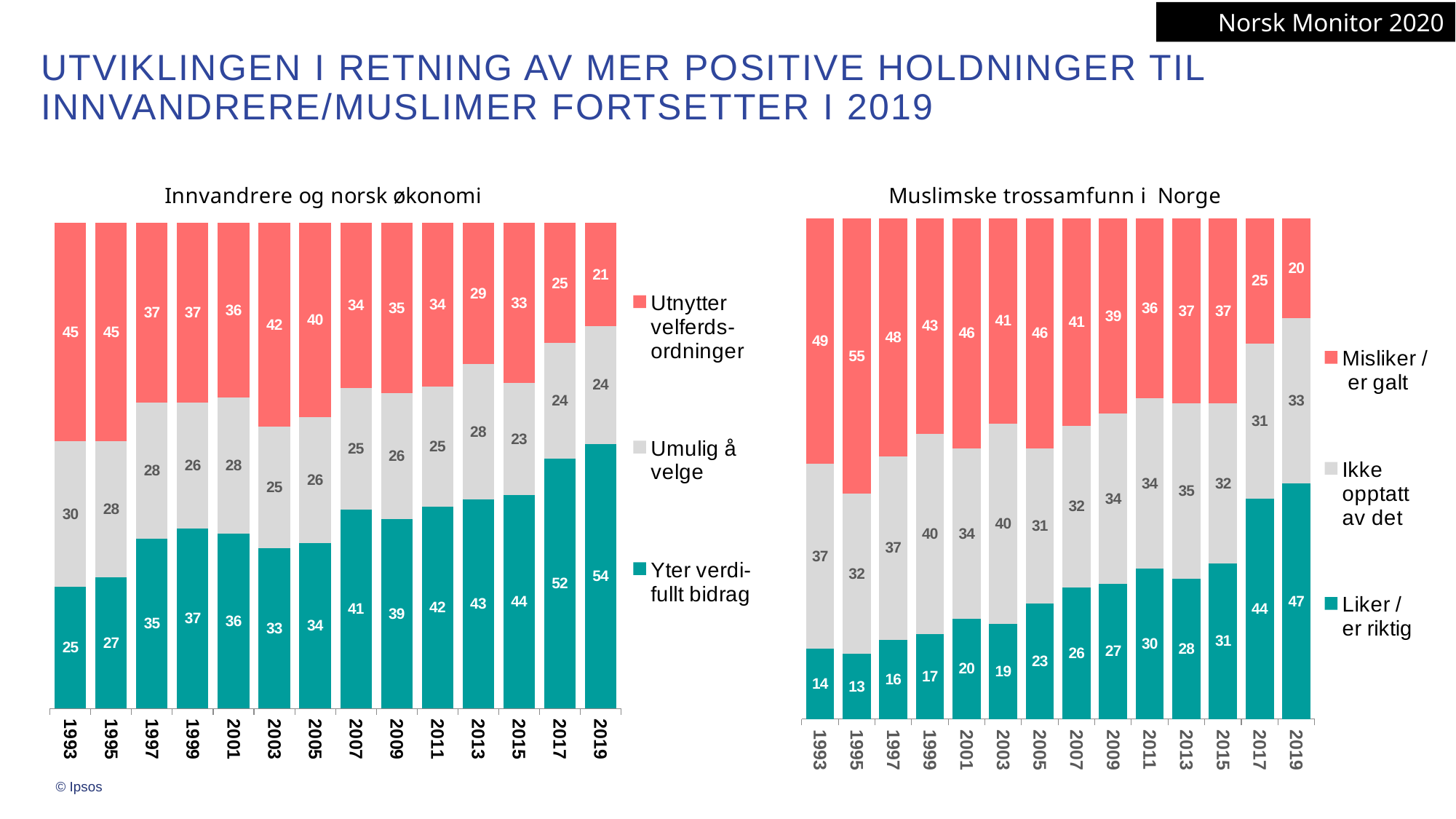
In the 'Muslimske trossamfunn i Norge' chart, which year has the lowest value for 'Liker / er riktig'? 1995 In the 'Muslimske trossamfunn i Norge' chart, does the 'Misliker / er galt' series generally rise or fall from 1993 to 2019? Fall In the 'Muslimske trossamfunn i Norge' chart, is the 'Ikke opptatt av det' value larger in 1999 or in 2005? 1999 In the 'Innvandrere og norsk økonomi' chart, what is the total of the stacked bar for 1993? 100 What kind of chart is the 'Innvandrere og norsk økonomi' chart? Stacked bar chart In the 'Muslimske trossamfunn i Norge' chart, what is the difference between the 'Liker / er riktig' values for 2019 and 2017? 3 In the 'Innvandrere og norsk økonomi' chart, what is the difference between the 'Yter verdifullt bidrag' values for 2019 and 1993? 29 In the 'Innvandrere og norsk økonomi' chart, which year has the highest value for 'Utnytter velferdsordninger'? 1993 and 1995 (45) How many series does the legend of the 'Muslimske trossamfunn i Norge' chart list? 3 In the 'Muslimske trossamfunn i Norge' chart, what is the value for 'Misliker / er galt' in 1995? 55 In the 'Innvandrere og norsk økonomi' chart, what is the value for 'Yter verdifullt bidrag' in 2019? 54 How many years are shown on the x axis of the 'Innvandrere og norsk økonomi' chart? 14